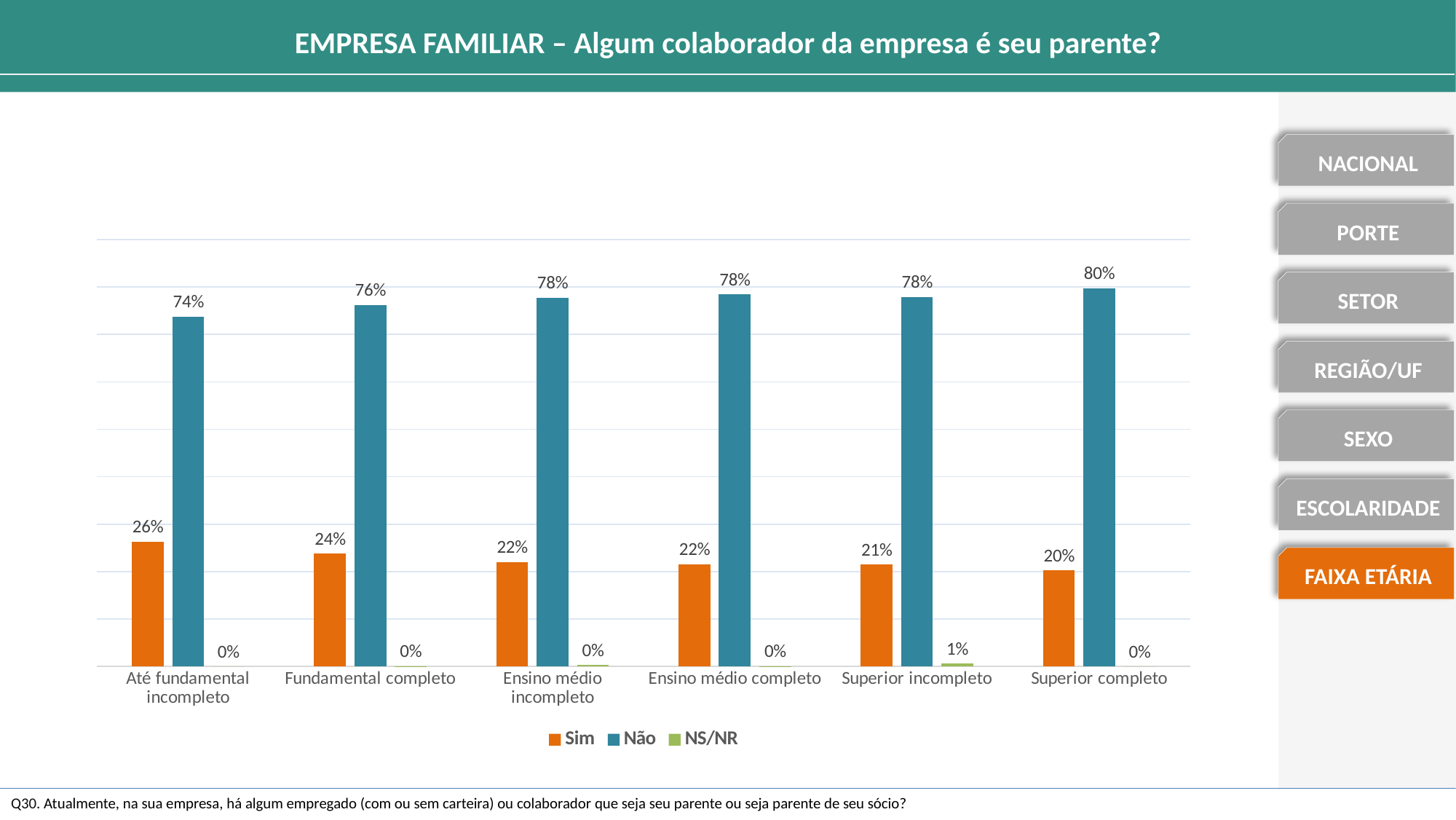
Which category has the highest "Não" value? Superior completo What is the value of "Sim" for "Até fundamental incompleto"? 26% Which category has the lowest "Sim" value? Superior completo What is the value of "Não" for "Superior completo"? 80% What is the difference between the "Não" values for "Superior completo" and "Até fundamental incompleto"? 6% How many series does the legend list? 3 What is the value of "NS/NR" for "Superior incompleto"? 1% Which is larger: the "Sim" value for "Fundamental completo" or for "Superior incompleto"? Fundamental completo What kind of chart is shown on the slide? Bar chart What are the three series listed in the legend? Sim, Não, NS/NR How many categories are shown on the x axis? 6 Do the "Sim" values rise or fall from left to right across the categories? Fall